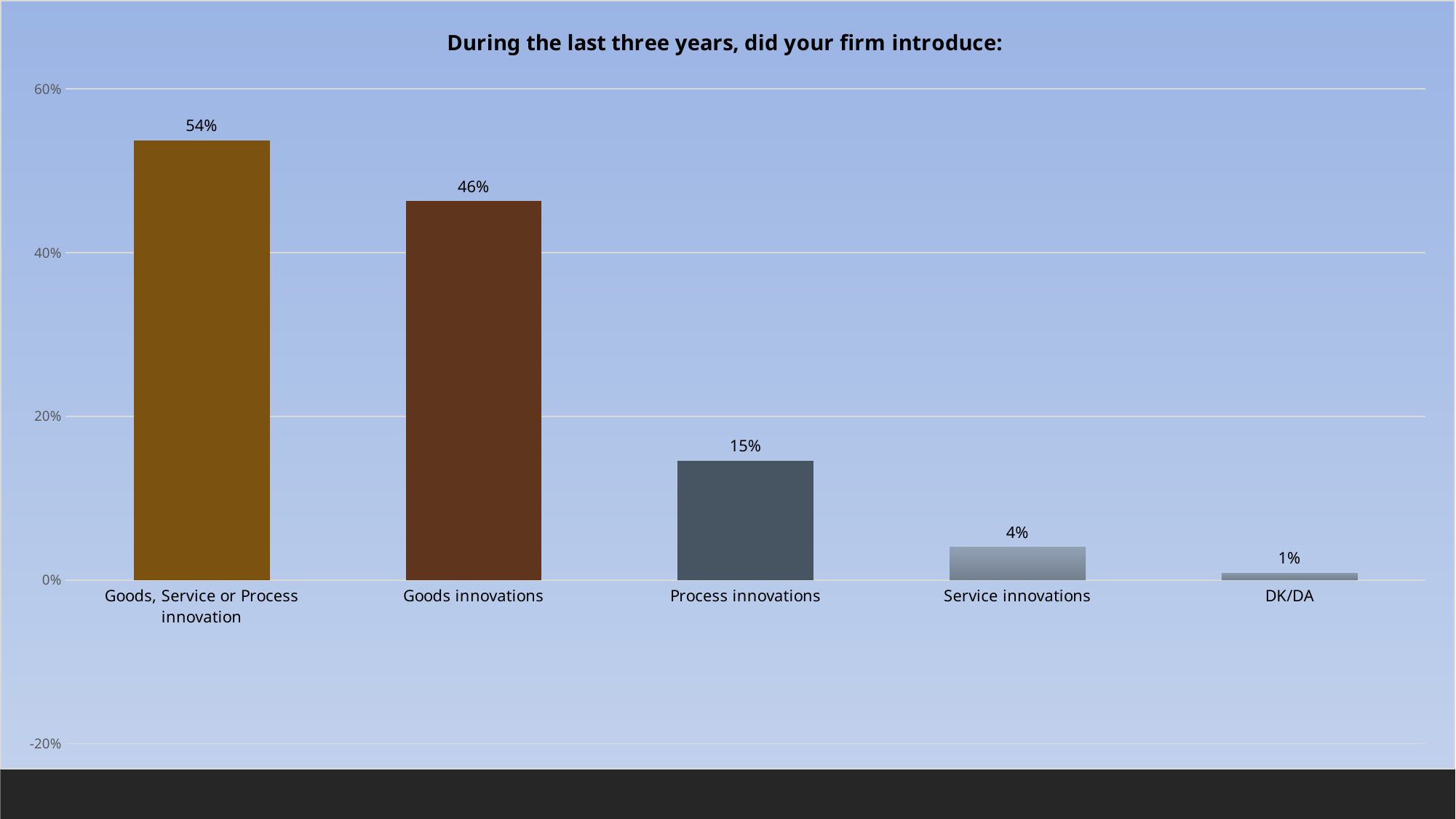
What is the value for DK/DA? 1% What is the value for Goods innovations? 46% How many categories are shown on the x axis? 5 What is the title of the chart? During the last three years, did your firm introduce: What kind of chart is shown on the slide? bar chart What is the difference between the values for Goods, Service or Process innovation and Goods innovations? 8% What is the value for Process innovations? 15% Which is larger, the value for Process innovations or the value for Service innovations? Process innovations Is the value for Goods innovations greater or less than 40%? greater Which category has the lowest value? DK/DA Which category has the highest value? Goods, Service or Process innovation What is the value for Service innovations? 4%